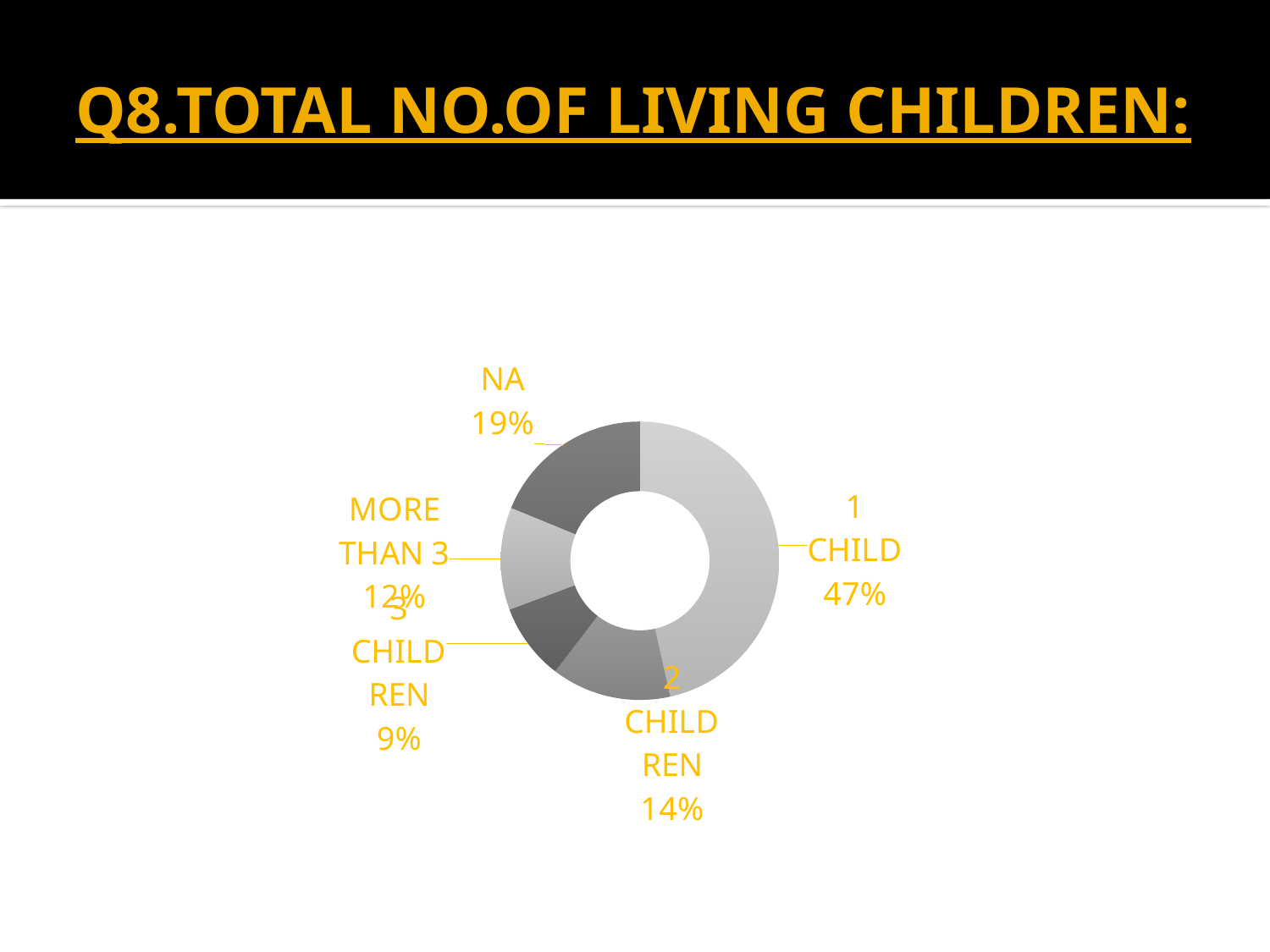
What kind of chart is shown on the slide? Doughnut chart What is the title of the slide? Q8.TOTAL NO.OF LIVING CHILDREN: What percentage of respondents have 3 children? 9% Which category has the largest share of the chart? 1 CHILD What percentage is shown for the NA category? 19% What is the combined percentage of the 1 CHILD and NA categories? 66% What is the difference in percentage points between the 1 CHILD and 2 CHILDREN categories? 33 What percentage of respondents have 2 children? 14% What percentage of respondents have 1 child? 47% Which is larger, the share for NA or the share for 2 CHILDREN? NA How many categories are shown in the chart? 5 Which category has the smallest share of the chart? 3 CHILDREN